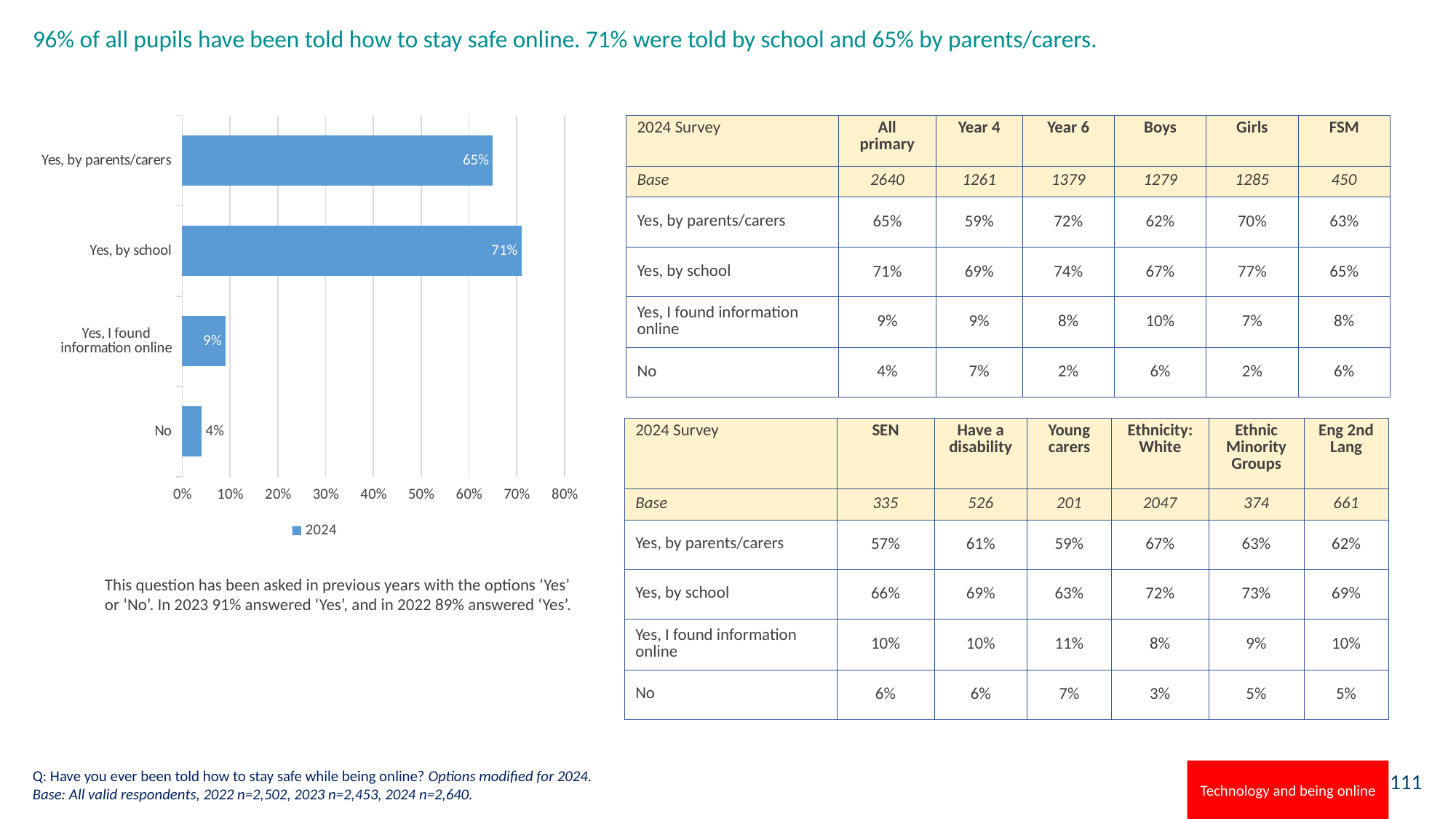
What is the difference between the values for 'Yes, by school' and 'Yes, by parents/carers' in the bar chart? 6% What is the value for 'No' in the bar chart? 4% How many categories are shown in the bar chart? 4 What is the value for 'Yes, by parents/carers' in the bar chart? 65% Which is larger in the bar chart: 'Yes, I found information online' or 'No'? Yes, I found information online What is the value for 'Yes, I found information online' in the bar chart? 9% How many series does the legend of the bar chart list? 1 Which category has the highest value in the bar chart? Yes, by school What kind of chart is shown on the slide? Bar chart What is the value for 'Yes, by school' in the bar chart? 71% What series name is shown in the legend of the bar chart? 2024 Which category has the lowest value in the bar chart? No